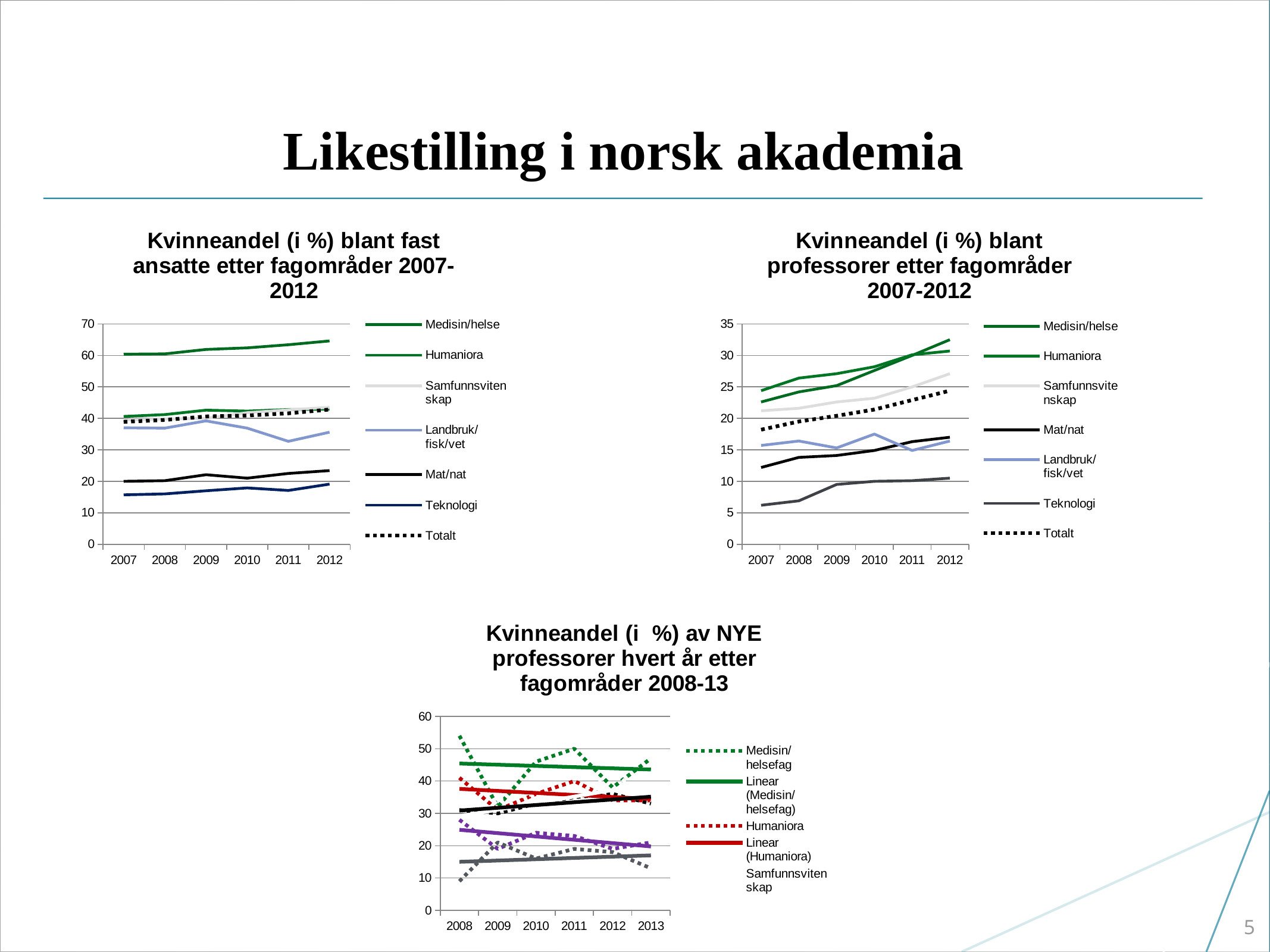
In the chart titled "Kvinneandel (i %) blant professorer etter fagområder 2007-2012", which series has the lowest values? Teknologi What kind of chart is the chart titled "Kvinneandel (i %) blant fast ansatte etter fagområder 2007-2012"? line chart In the chart titled "Kvinneandel (i %) blant fast ansatte etter fagområder 2007-2012", which series has the lowest values? Teknologi In the chart titled "Kvinneandel (i %) av NYE professorer hvert år etter fagområder 2008-13", is the value for Medisin/helsefag in 2008 greater or less than 50? greater In the chart titled "Kvinneandel (i %) blant professorer etter fagområder 2007-2012", which series is drawn as a dotted line? Totalt In the chart titled "Kvinneandel (i %) blant professorer etter fagområder 2007-2012", does the Mat/nat series rise or fall from 2007 to 2012? rise In the chart titled "Kvinneandel (i %) blant fast ansatte etter fagområder 2007-2012", is the value for Medisin/helse in 2012 greater or less than 60? greater In the chart titled "Kvinneandel (i %) blant professorer etter fagområder 2007-2012", is the value for Medisin/helse in 2012 greater or less than 30? greater In the chart titled "Kvinneandel (i %) blant fast ansatte etter fagområder 2007-2012", which series has the highest values? Medisin/helse In the chart titled "Kvinneandel (i %) blant fast ansatte etter fagområder 2007-2012", how many series does the legend list? 7 In the chart titled "Kvinneandel (i %) blant fast ansatte etter fagområder 2007-2012", how many years are shown on the x axis? 6